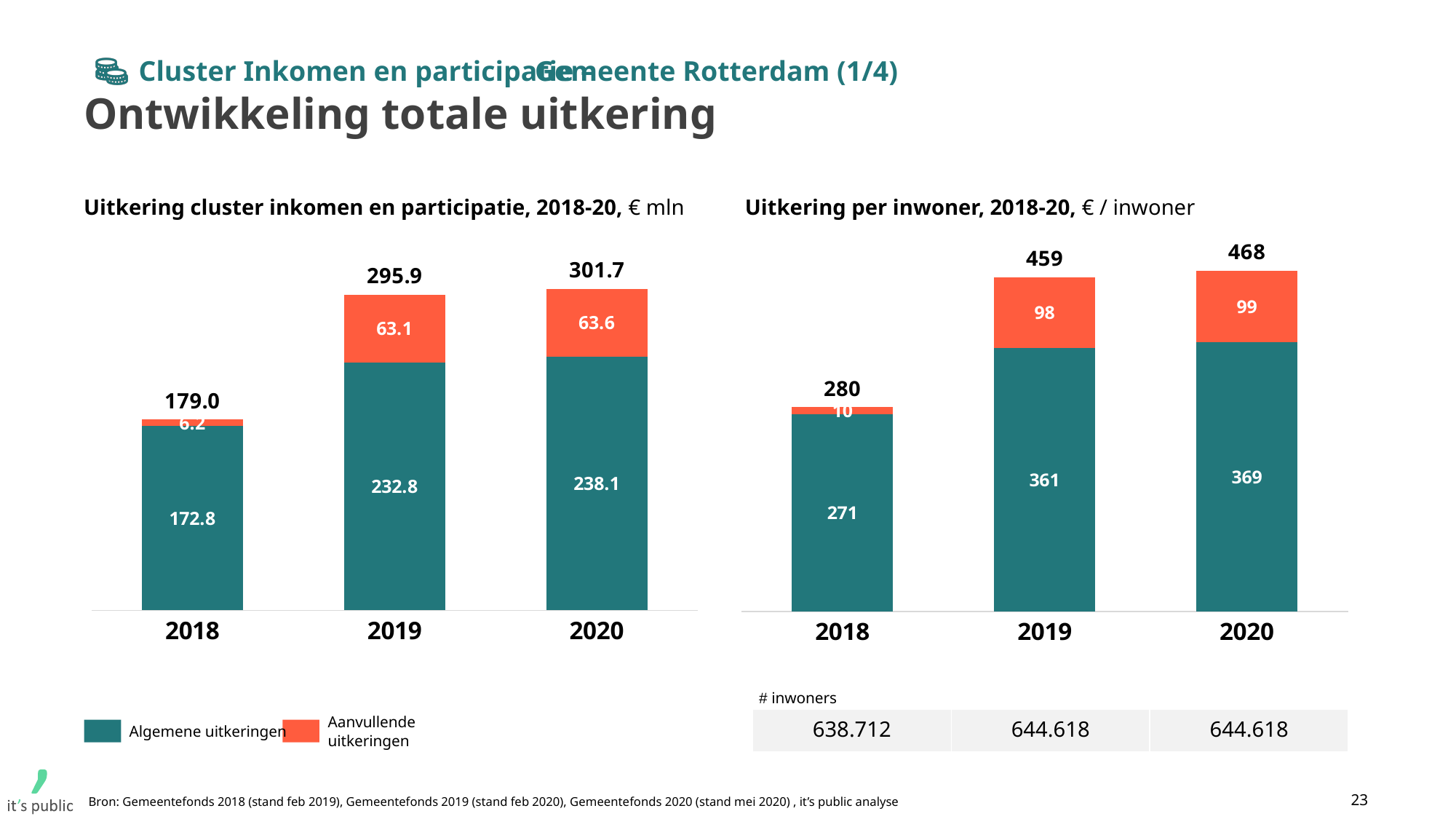
In the right chart (Uitkering per inwoner), do the totals rise or fall from 2018 to 2020? rise In the left chart (Uitkering cluster inkomen en participatie), what is the total for 2020? 301.7 In the right chart (Uitkering per inwoner), which year has the highest total? 2020 In the right chart (Uitkering per inwoner), what is the total for 2019? 459 In the left chart (Uitkering cluster inkomen en participatie), which year has the lowest total? 2018 How many series does the legend list? 2 In the left chart (Uitkering cluster inkomen en participatie), what is the difference between the totals for 2020 and 2019? 5.8 What kind of chart is the left chart (Uitkering cluster inkomen en participatie)? stacked bar chart In the right chart (Uitkering per inwoner), what is the value of Algemene uitkeringen for 2020? 369 In the left chart (Uitkering cluster inkomen en participatie), what is the value of Aanvullende uitkeringen for 2018? 6.2 In the left chart (Uitkering cluster inkomen en participatie), what is the value of Algemene uitkeringen for 2019? 232.8 In the right chart (Uitkering per inwoner), what is the difference between the totals for 2019 and 2018? 179